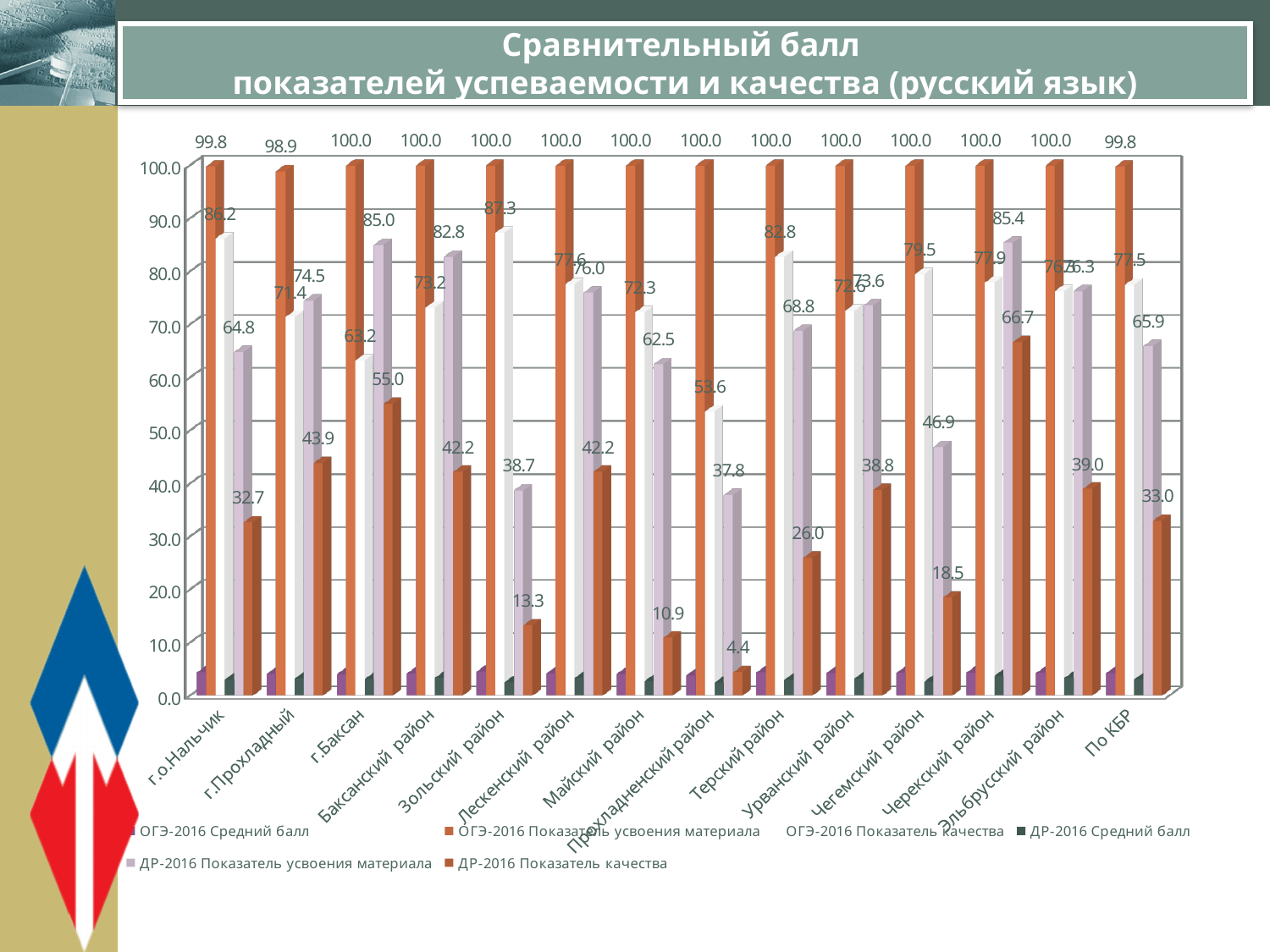
What is the value of ДР-2016 Показатель качества for По КБР? 33.0 Which category has the lowest value for ДР-2016 Показатель качества? Прохладненский район How many categories are shown on the x axis? 14 What is the difference between the ДР-2016 Показатель качества values for Черекский район and Эльбрусский район? 27.7 Which has the larger ДР-2016 Показатель усвоения материала value: г.Баксан or Зольский район? г.Баксан What is the value of ДР-2016 Показатель усвоения материала for Зольский район? 38.7 What kind of chart is shown on the slide? Bar chart What is the difference between ОГЭ-2016 Показатель качества and ДР-2016 Показатель качества for Зольский район? 74.0 What is the value of ОГЭ-2016 Показатель усвоения материала for г.Прохладный? 98.9 Which category has the highest value for ДР-2016 Показатель качества? Черекский район What is the value of ДР-2016 Показатель качества for Прохладненский район? 4.4 How many series does the legend list? 6